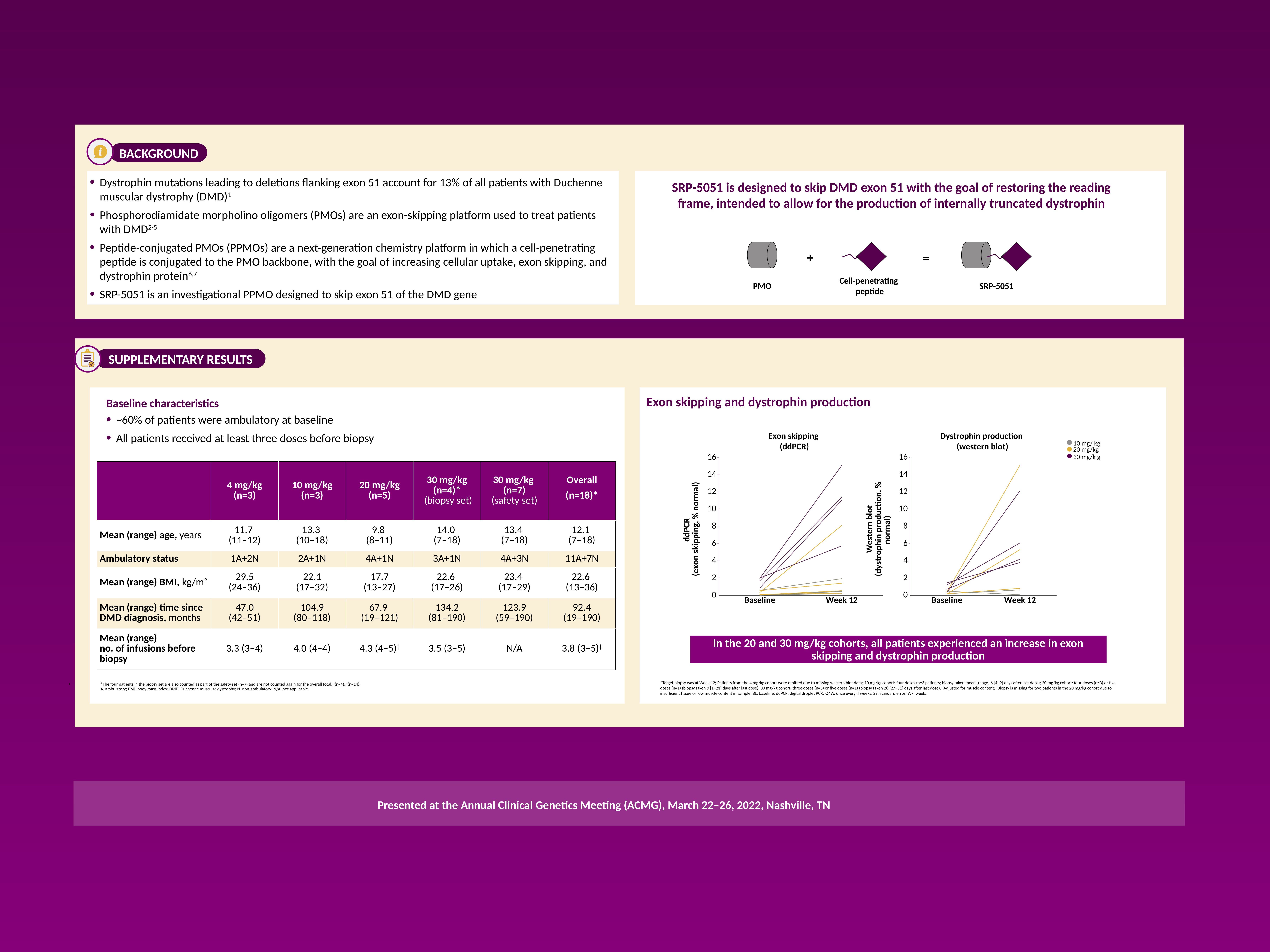
In the "Dystrophin production (western blot)" chart, is the highest Week 12 value greater or less than 16? less What are the two x-axis labels on the "Dystrophin production (western blot)" chart? Baseline and Week 12 In the "Dystrophin production (western blot)" chart, is the highest Week 12 value greater or less than 12? greater How many time points are shown on the x axis of the "Exon skipping (ddPCR)" chart? 2 In the "Exon skipping (ddPCR)" chart, are all Baseline values greater or less than 4? less What kind of chart is the "Dystrophin production (western blot)" chart? line chart What kind of chart is the "Exon skipping (ddPCR)" chart? line chart What is the maximum value shown on the y axis of the "Exon skipping (ddPCR)" chart? 16 In the "Exon skipping (ddPCR)" chart, do the 30 mg/kg lines rise or fall from Baseline to Week 12? rise How many dose cohorts does the legend list for the exon skipping and dystrophin production charts? 3 In the "Dystrophin production (western blot)" chart, do the 20 mg/kg lines rise or fall from Baseline to Week 12? rise